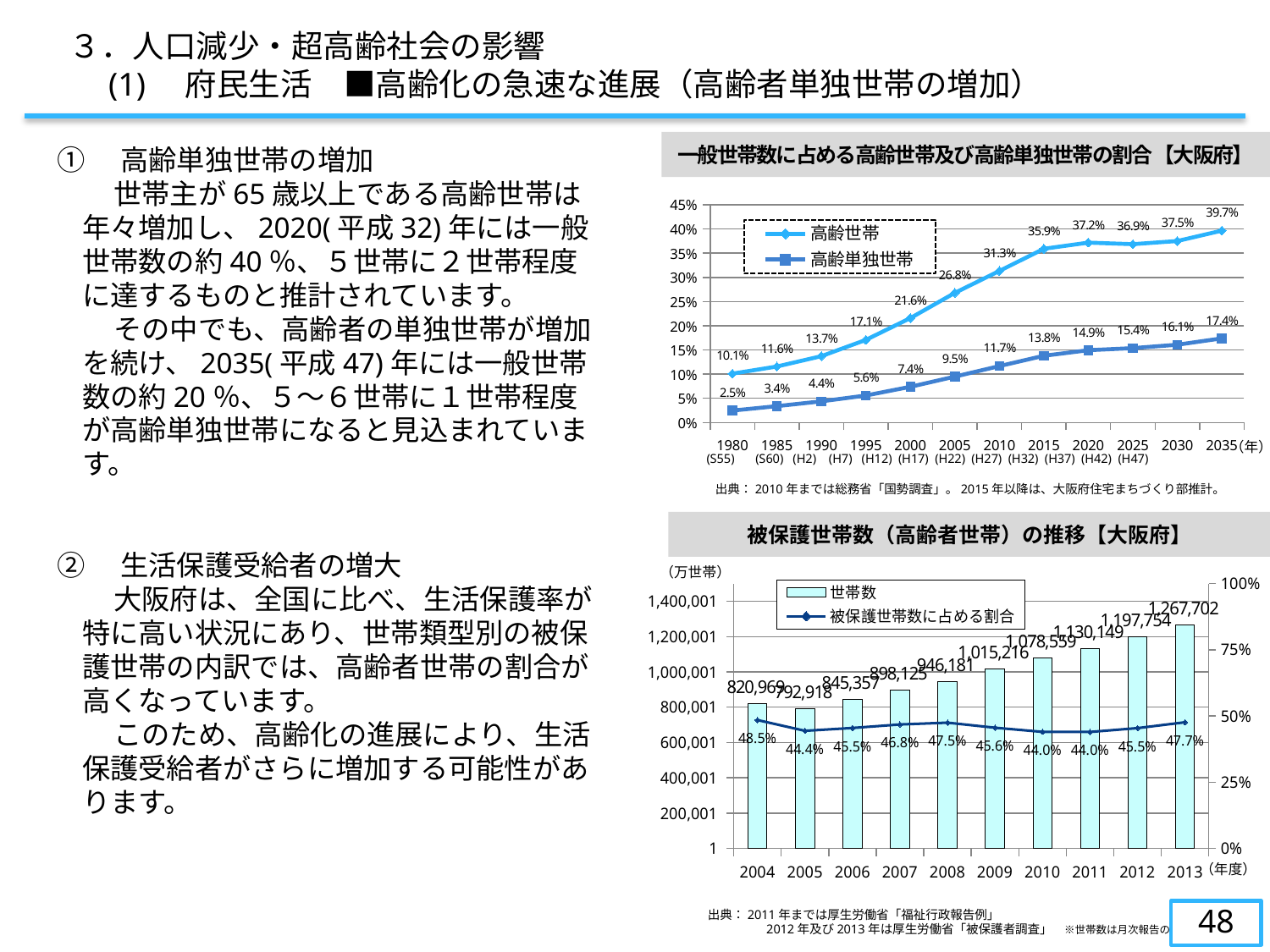
In the bottom chart (被保護世帯数（高齢者世帯）の推移【大阪府】), how many years are shown on the x axis? 10 In the top chart (一般世帯数に占める高齢世帯及び高齢単独世帯の割合【大阪府】), what is the value for 高齢単独世帯 in 1980? 2.5% In the bottom chart (被保護世帯数（高齢者世帯）の推移【大阪府】), what is the difference in 世帯数 between 2013 and 2012? 69,948 In the top chart (一般世帯数に占める高齢世帯及び高齢単独世帯の割合【大阪府】), what is the value for 高齢世帯 in 2035? 39.7% In the top chart (一般世帯数に占める高齢世帯及び高齢単独世帯の割合【大阪府】), does the 高齢単独世帯 series rise or fall from 1980 to 2035? rise In the bottom chart (被保護世帯数（高齢者世帯）の推移【大阪府】), is the 世帯数 for 2009 larger or smaller than the 世帯数 for 2008? larger In the bottom chart (被保護世帯数（高齢者世帯）の推移【大阪府】), which year has the lowest 世帯数? 2005 In the bottom chart (被保護世帯数（高齢者世帯）の推移【大阪府】), what is the 被保護世帯数に占める割合 value for 2004? 48.5% In the top chart (一般世帯数に占める高齢世帯及び高齢単独世帯の割合【大阪府】), what kind of chart is it? line chart In the top chart (一般世帯数に占める高齢世帯及び高齢単独世帯の割合【大阪府】), what is the difference between 高齢世帯 and 高齢単独世帯 in 2010? 19.6% In the top chart (一般世帯数に占める高齢世帯及び高齢単独世帯の割合【大阪府】), how many series does the legend list? 2 In the bottom chart (被保護世帯数（高齢者世帯）の推移【大阪府】), what is the 世帯数 value for 2013? 1,267,702